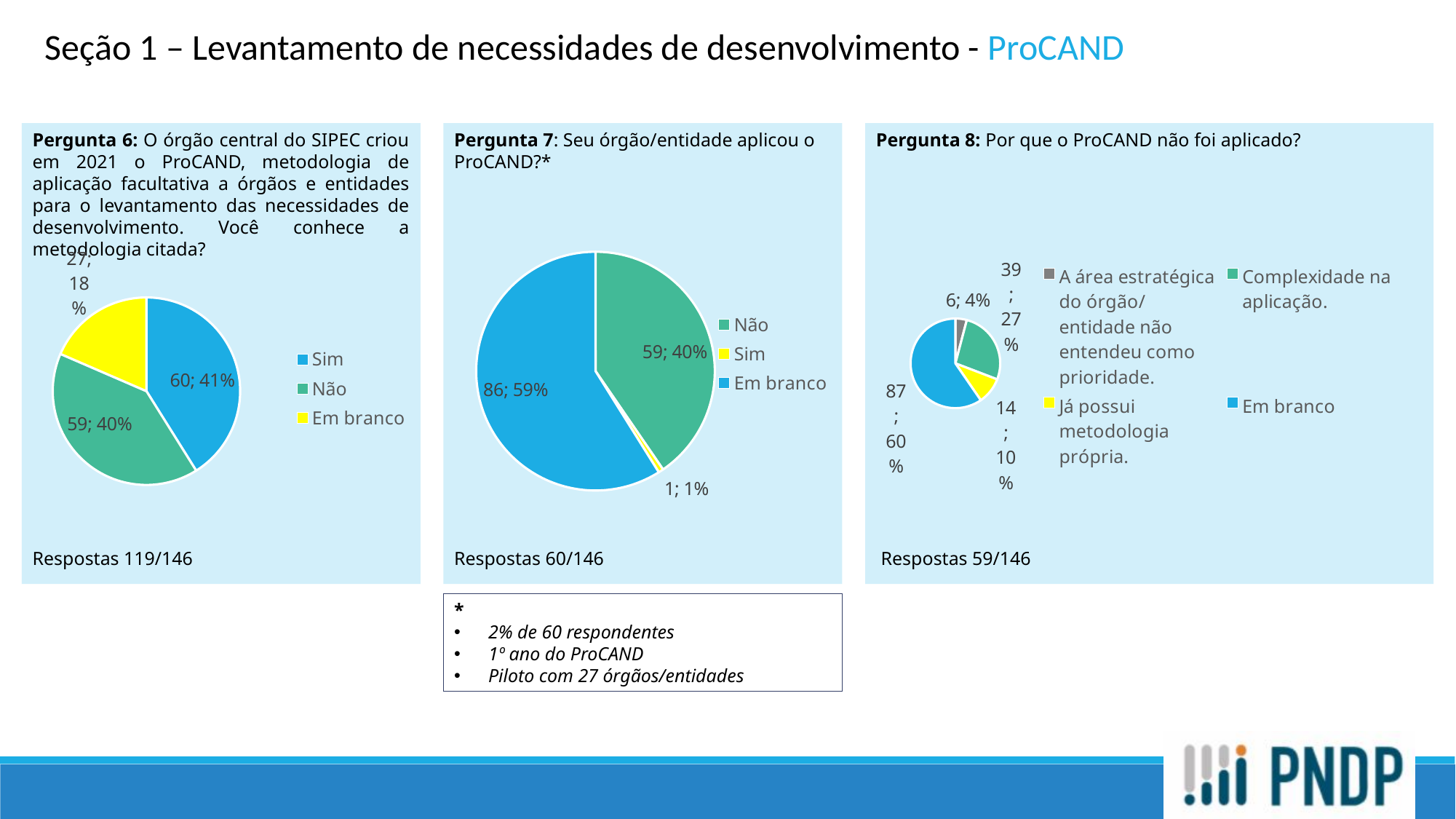
In the Pergunta 8 pie chart, how many categories are shown? 4 In the Pergunta 7 pie chart, how many categories does the legend list? 3 In the Pergunta 6 pie chart, what is the difference between the counts for "Sim" and "Em branco"? 33 What type of chart is used for Pergunta 6? Pie chart In the Pergunta 6 pie chart, which category has the smallest slice? Em branco In the Pergunta 8 pie chart, what is the value and share shown for "Complexidade na aplicação"? 39; 27% In the Pergunta 8 pie chart, which is larger: "Já possui metodologia própria" or "Complexidade na aplicação"? Complexidade na aplicação In the Pergunta 7 pie chart, which category has the largest slice? Em branco In the Pergunta 6 pie chart, what is the value and share shown for "Sim"? 60; 41% In the Pergunta 8 pie chart, which category has the smallest slice? A área estratégica do órgão/entidade não entendeu como prioridade. In the Pergunta 7 pie chart, what percentage share does "Sim" have? 1% In the Pergunta 7 pie chart, what is the value and share shown for "Em branco"? 86; 59%